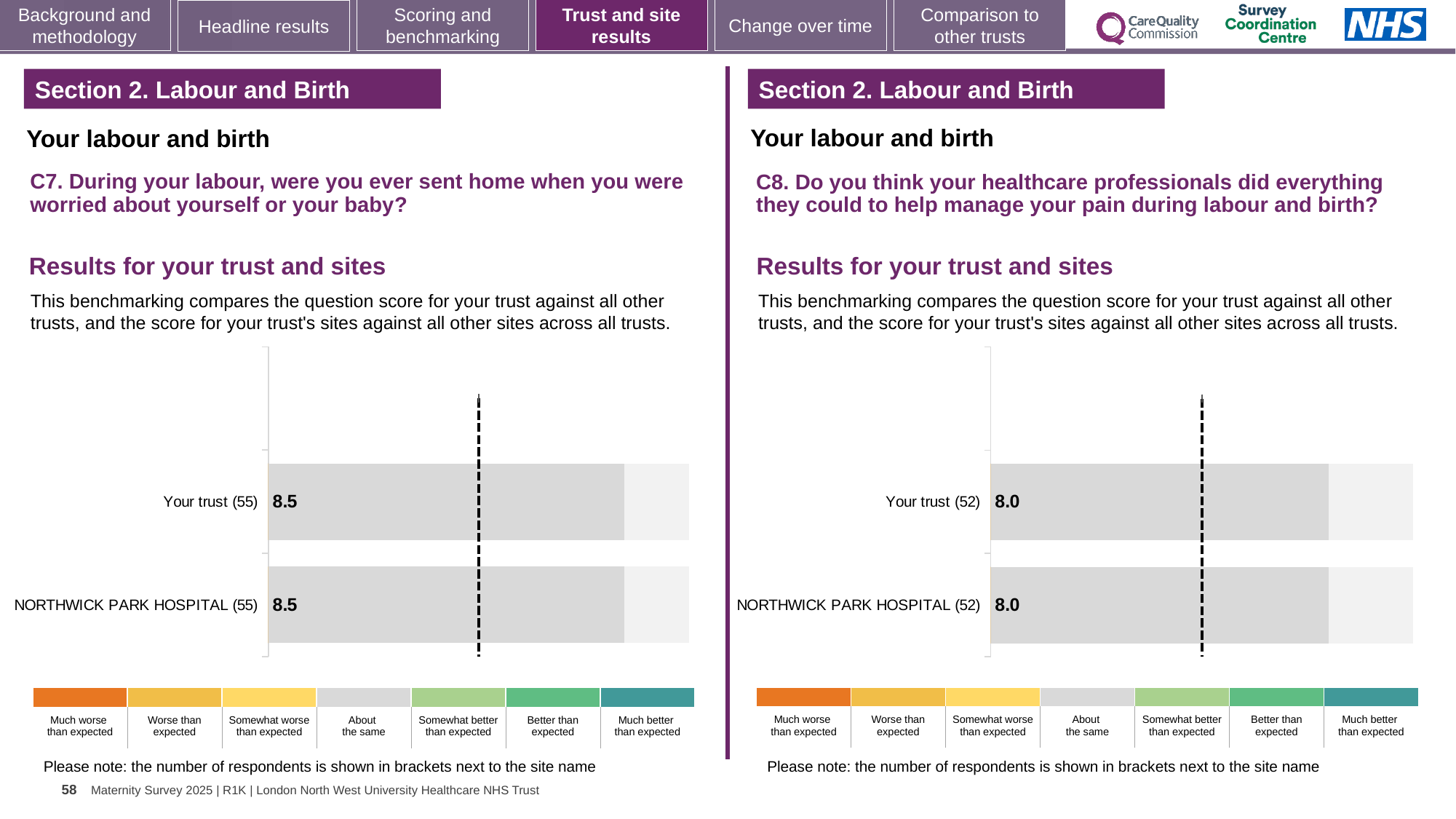
In the C8 chart on the right, what is the score for NORTHWICK PARK HOSPITAL? 8.0 In the C8 chart on the right, is the score for Your trust higher than, lower than, or equal to the score for NORTHWICK PARK HOSPITAL? Equal In the C8 chart on the right, how many respondents are shown in brackets next to NORTHWICK PARK HOSPITAL? 52 How many bars are plotted in the C8 chart on the right? 2 In the C8 chart on the right, what is the score for Your trust? 8.0 What kind of chart is used for the C7 results on the left? Bar chart In the C7 chart on the left, what is the score for Your trust? 8.5 In the C7 chart on the left, how many respondents are shown in brackets next to Your trust? 55 In the C7 chart on the left, what is the difference between the score for Your trust and the score for NORTHWICK PARK HOSPITAL? 0.0 How many bars are plotted in the C7 chart on the left? 2 In the C7 chart on the left, what is the score for NORTHWICK PARK HOSPITAL? 8.5